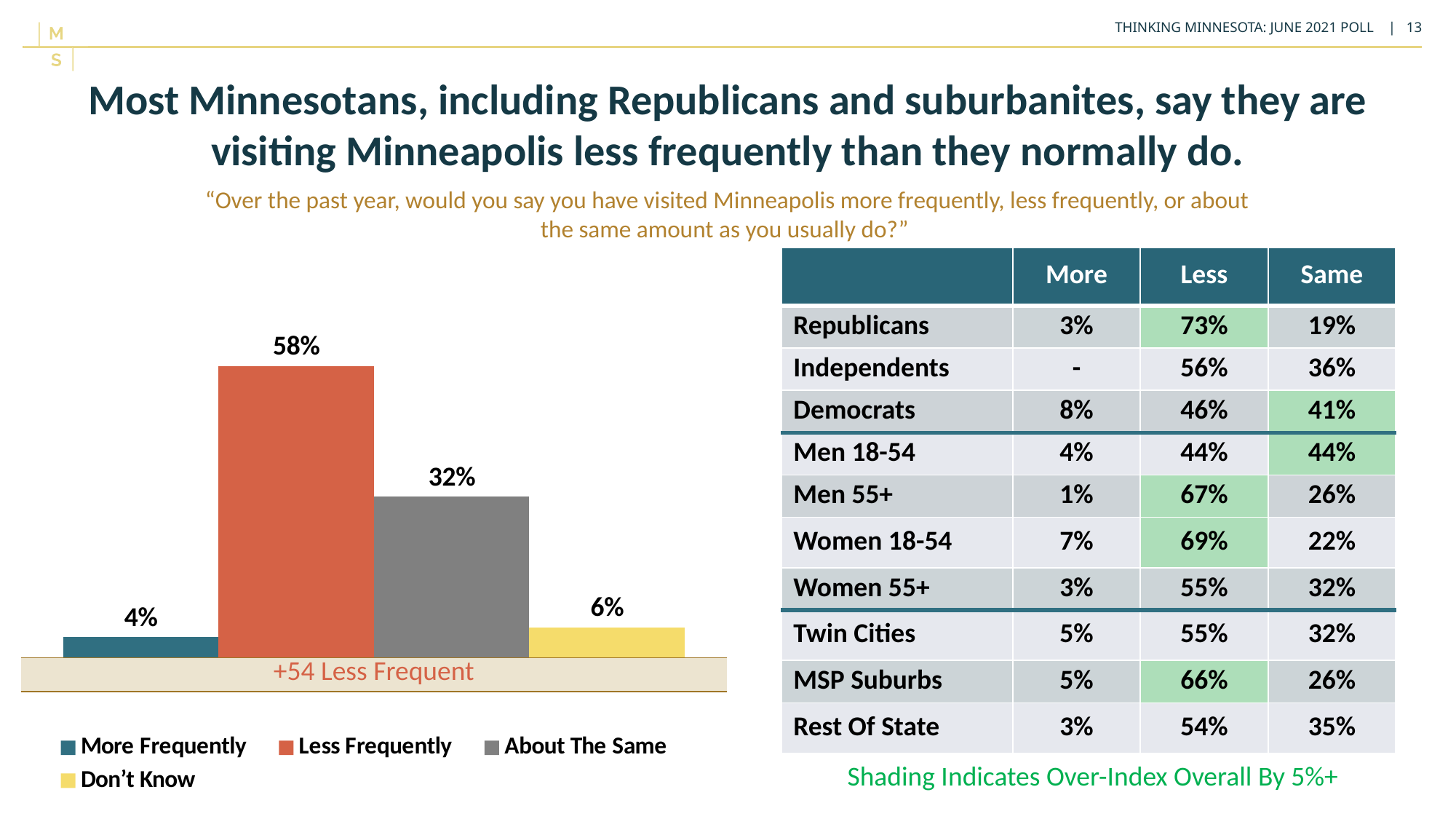
What is the difference between the Less Frequently and About The Same percentages? 26 percentage points What type of chart is used to show the overall responses? Bar chart What percentage of respondents said they visited Minneapolis about the same amount? 32% What percentage of respondents said they visited Minneapolis less frequently? 58% How many response categories are shown in the bar chart? 4 What is the difference between the Less Frequently and More Frequently percentages? 54 percentage points What percentage of respondents answered Don't Know? 6% Which is larger, the Don't Know value or the More Frequently value? Don't Know Which response category has the lowest value in the bar chart? More Frequently What percentage of respondents said they visited Minneapolis more frequently? 4% What net figure is printed beneath the bars in the chart? +54 Less Frequent Which response category has the highest value in the bar chart? Less Frequently